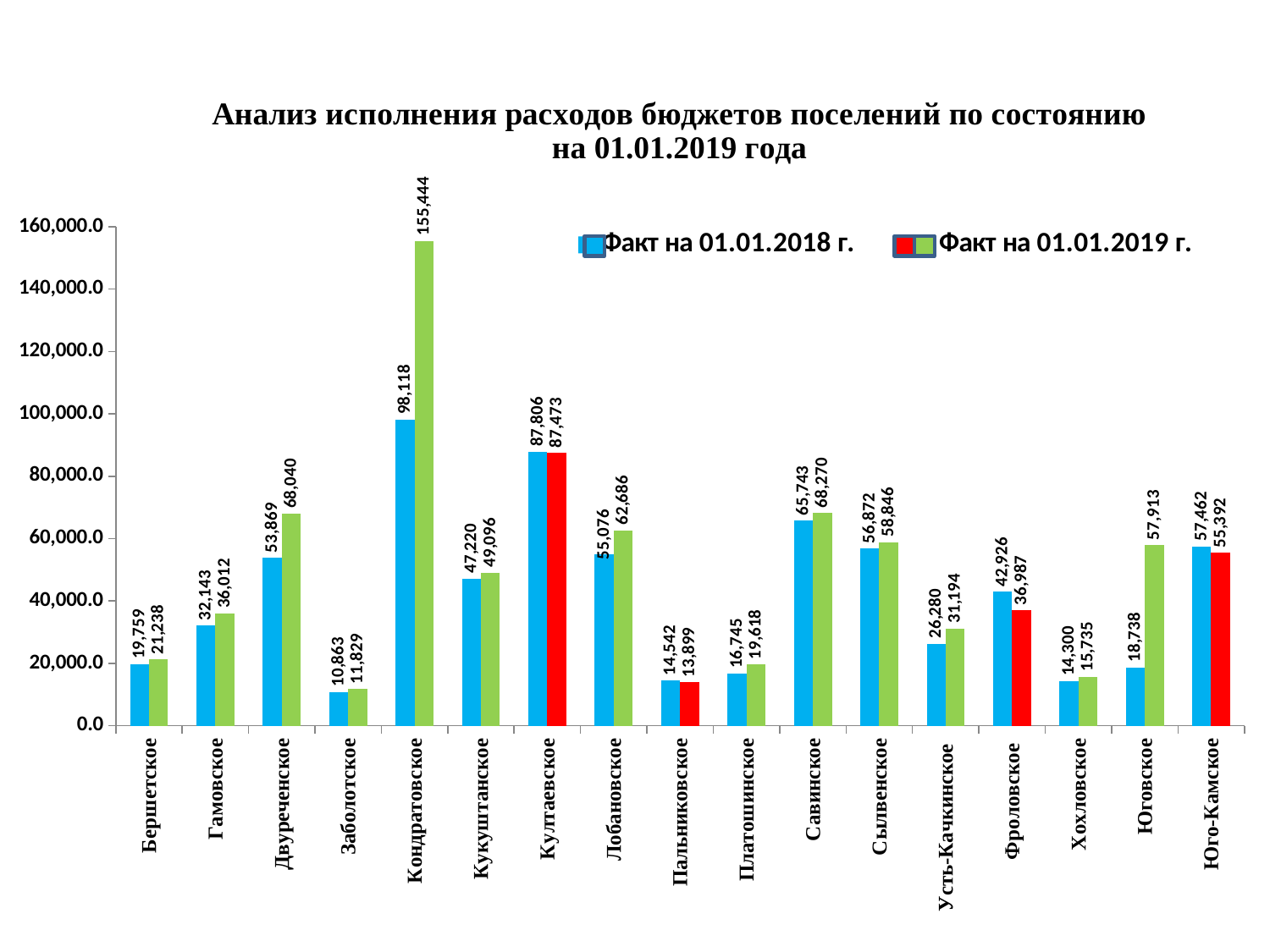
Which category has the lowest value in the series Факт на 01.01.2018 г.? Заболотское How many series does the legend list? 2 For Фроловское, which is larger: the Факт на 01.01.2018 г. value or the Факт на 01.01.2019 г. value? Факт на 01.01.2018 г. What is the value for Фроловское in the series Факт на 01.01.2018 г.? 42,926 Which category has the highest value in the series Факт на 01.01.2019 г.? Кондратовское Is the value for Двуреченское in the series Факт на 01.01.2019 г. greater or less than 60,000.0? greater How many categories are shown on the x axis? 17 What is the difference between the Факт на 01.01.2019 г. and Факт на 01.01.2018 г. values for Юговское? 39,175 What is the value for Юговское in the series Факт на 01.01.2019 г.? 57,913 What is the difference between the Факт на 01.01.2019 г. and Факт на 01.01.2018 г. values for Кондратовское? 57,326 What is the value for Кондратовское in the series Факт на 01.01.2019 г.? 155,444 What kind of chart is shown on the slide? bar chart